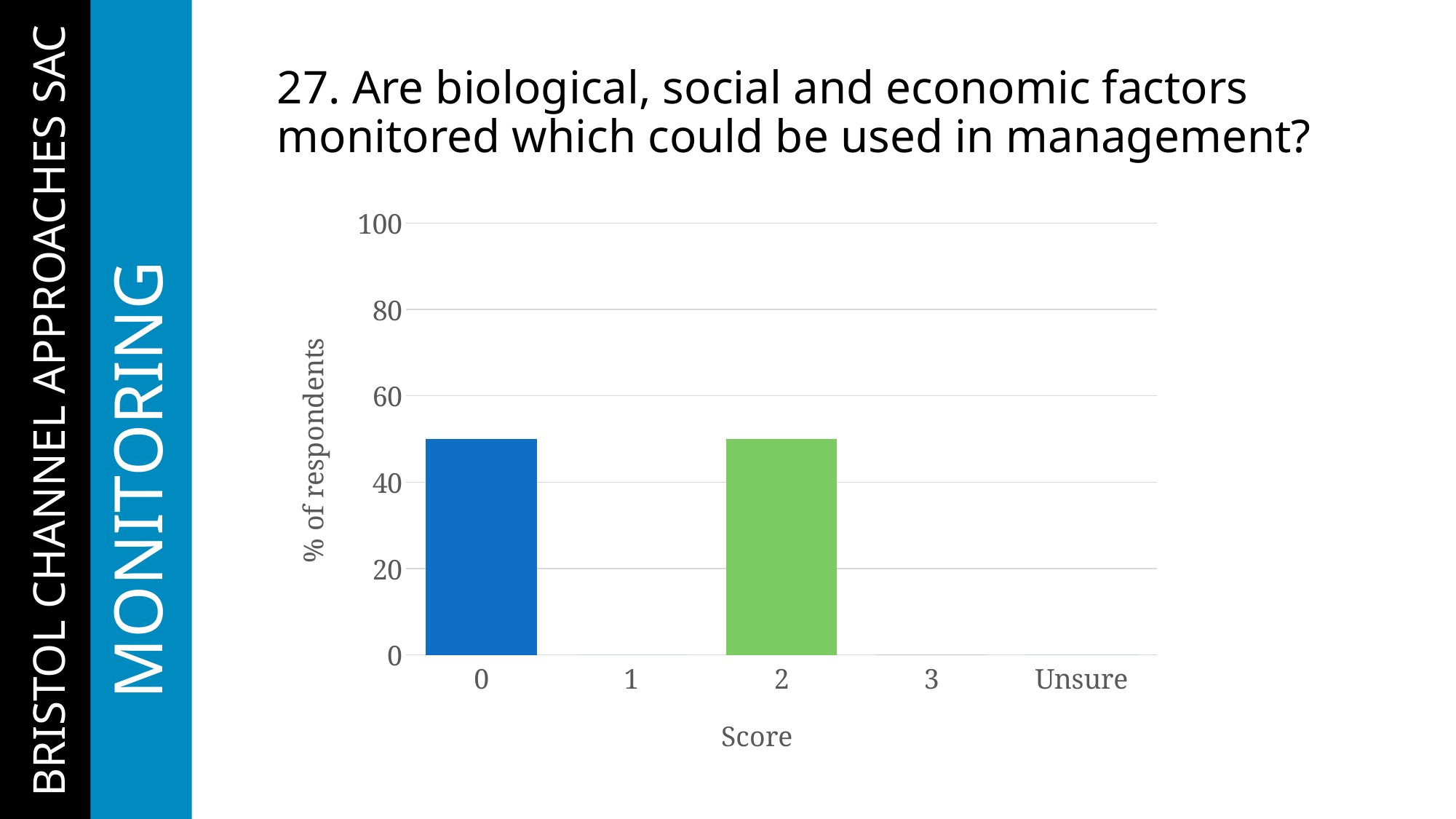
Is the value for score 2 greater or less than 60? less Is the value for score 0 greater or less than 60? less What is the label of the y axis? % of respondents How many of the score categories have a visible bar? 2 What is the value for Unsure? 0 Is the value for score 3 greater or less than 20? less What is the label of the x axis? Score How many score categories are shown on the x axis? 5 What is the value for score 1? 0 What kind of chart is shown on the slide? bar chart